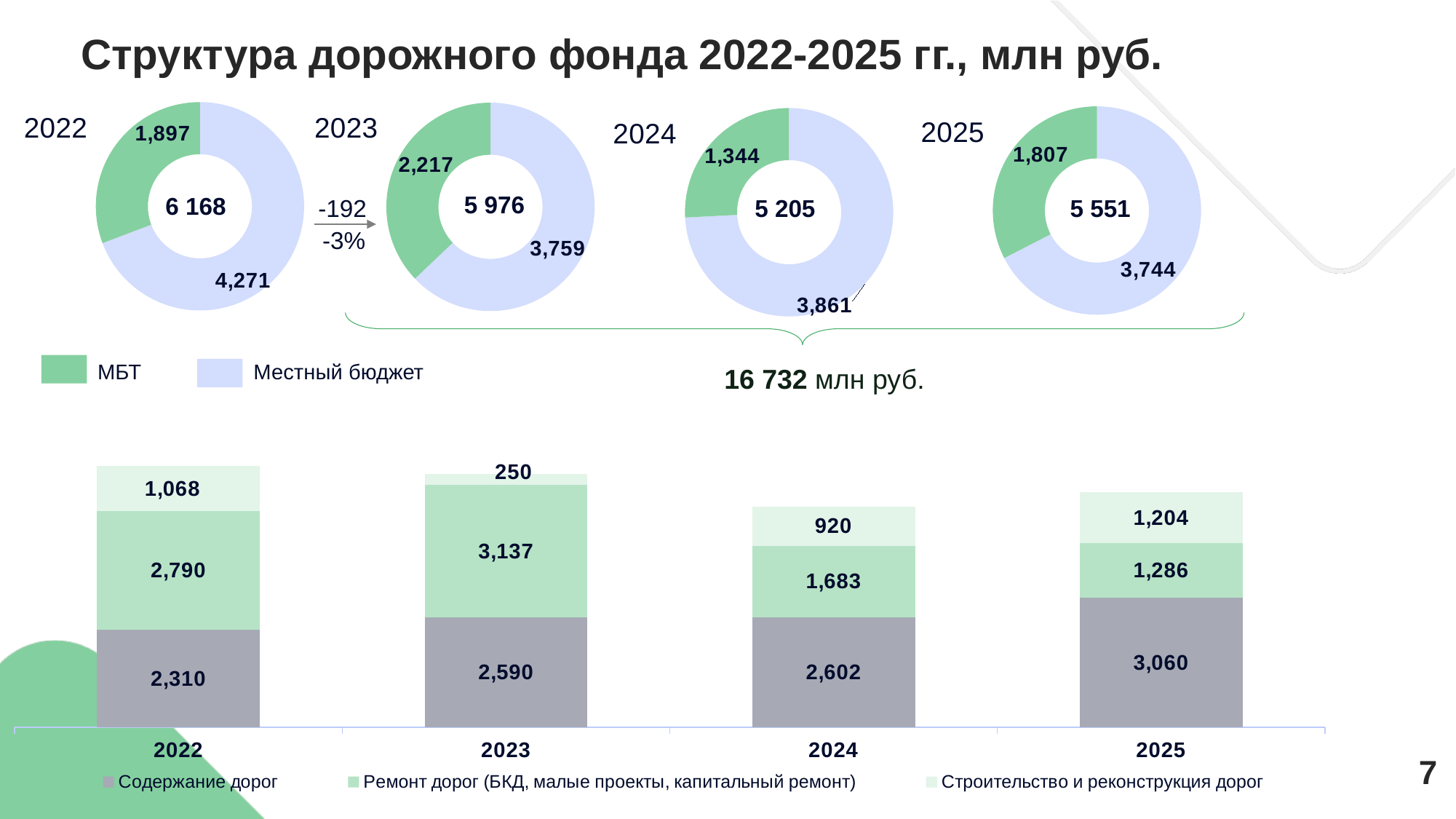
In the stacked bar chart, what is the value for Содержание дорог in 2023? 2,590 How many series does the legend of the stacked bar chart list? 3 What total is shown in the centre of the 2025 donut chart? 5 551 In the 2024 donut chart, what is the value for Местный бюджет? 3,861 In the stacked bar chart, which year has the lowest value for Строительство и реконструкция дорог? 2023 In the stacked bar chart, which year has the highest value for Содержание дорог? 2025 In the stacked bar chart, what is the total of the 2024 bar? 5,205 In the donut charts, what is the difference between the МБТ value for 2023 and the МБТ value for 2024? 873 In the stacked bar chart, is the Ремонт дорог value larger in 2022 or in 2023? 2023 In the stacked bar chart, does the value for Содержание дорог rise or fall from 2022 to 2025? rise Across the four donut charts, which year has the lowest МБТ value? 2024 In the 2022 donut chart, what is the value for МБТ? 1,897